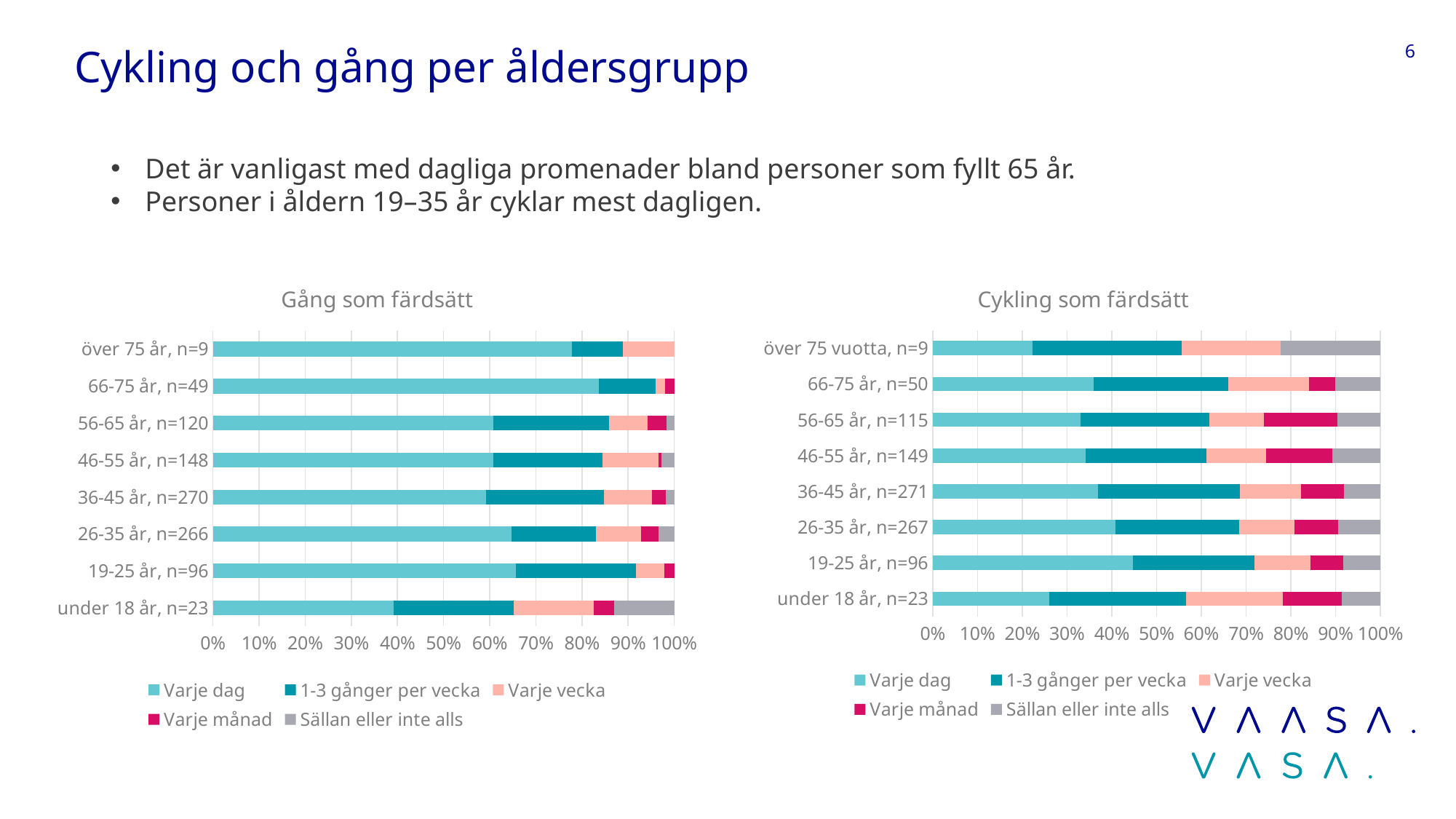
In the "Gång som färdsätt" chart, is the "Varje dag" share for "under 18 år, n=23" greater or less than 50%? less How many age groups are shown in the "Gång som färdsätt" chart? 8 In the "Cykling som färdsätt" chart, which age group has the lowest share for "Varje dag"? över 75 vuotta, n=9 In the "Cykling som färdsätt" chart, which age group has the highest share for "Varje dag"? 19-25 år, n=96 In the "Cykling som färdsätt" chart, is the "Varje dag" share for "under 18 år, n=23" greater or less than 30%? less In the "Gång som färdsätt" chart, is the "Varje dag" share for "66-75 år, n=49" greater or less than 80%? greater How many series does the legend of the "Cykling som färdsätt" chart list? 5 In the "Cykling som färdsätt" chart, which is larger: the "Varje dag" share for "19-25 år, n=96" or for "36-45 år, n=271"? 19-25 år, n=96 What is the title of the right-hand chart on the slide? Cykling som färdsätt In the "Gång som färdsätt" chart, which age group has the lowest share for "Varje dag"? under 18 år, n=23 What kind of chart is the left chart titled "Gång som färdsätt"? Stacked bar chart In the "Gång som färdsätt" chart, which age group has the highest share for "Varje dag"? 66-75 år, n=49